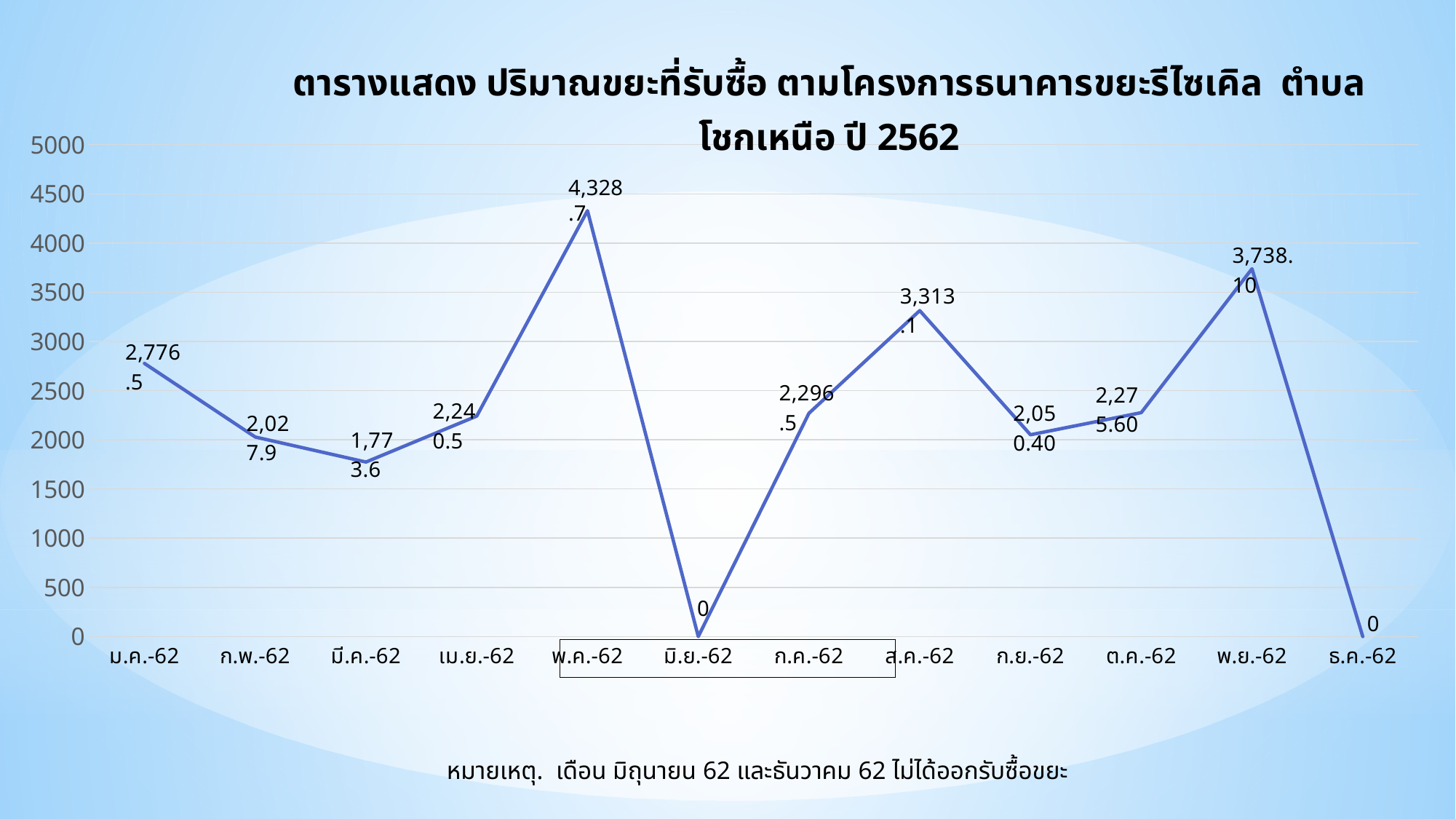
What is the difference between the values for พ.ค.-62 and พ.ย.-62? 590.6 What is the value for ม.ค.-62? 2,776.5 What type of chart is shown on the slide? Line chart What is the value for พ.ย.-62? 3,738.10 What is the value for ก.ย.-62? 2,050.40 How many months have a value of 0? 2 Which month has the highest value? พ.ค.-62 Which is larger, the value for ส.ค.-62 or the value for ก.ค.-62? ส.ค.-62 How many months are plotted on the x axis? 12 Do the values rise or fall from ม.ค.-62 to มี.ค.-62? fall What is the value for พ.ค.-62? 4,328.7 Is the value for ต.ค.-62 greater or less than 2000? greater